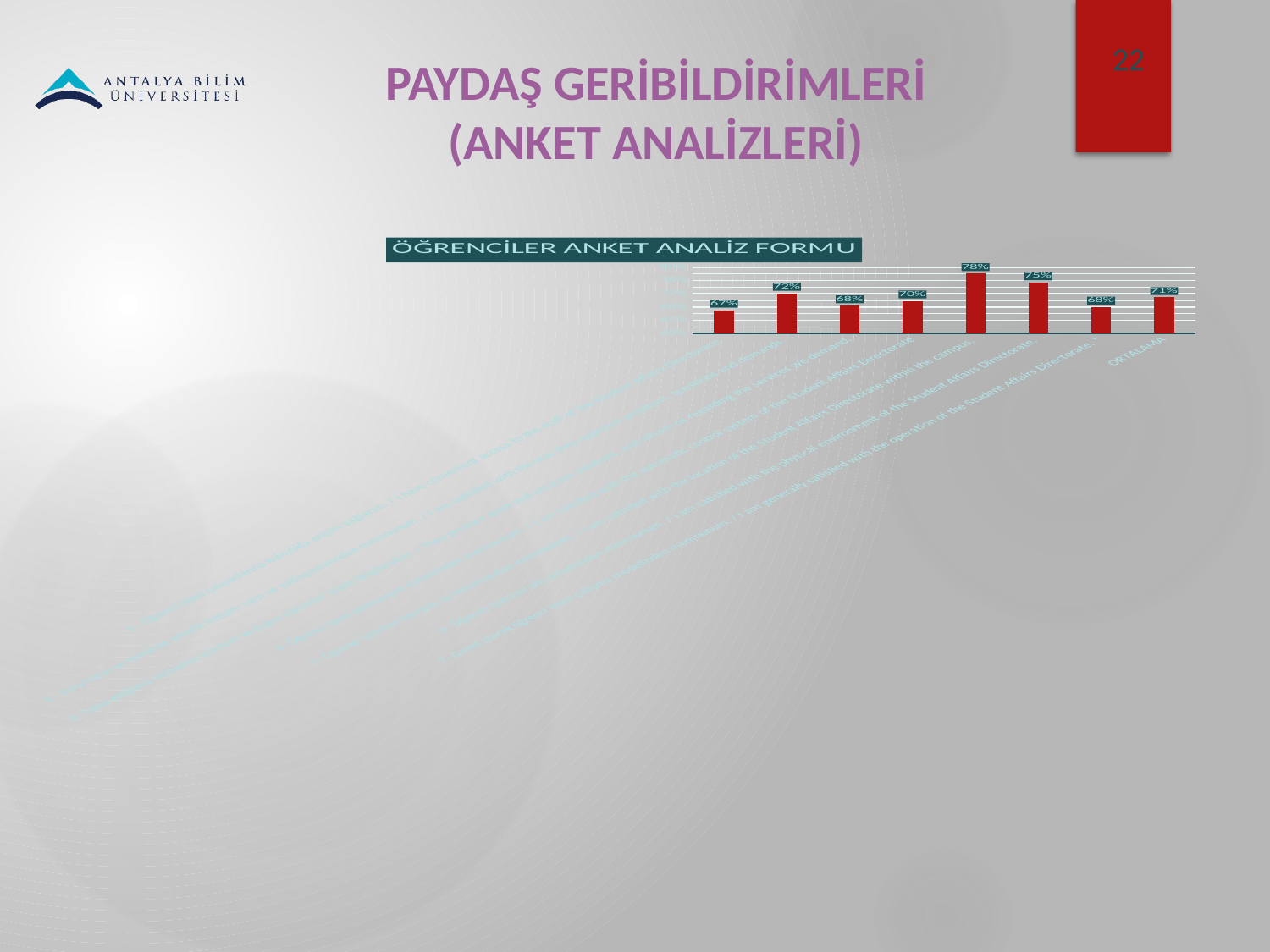
What is the difference between the fifth bar (78%) and the sixth bar (75%)? 3% Which is larger: the second bar from the left or the third bar from the left? the second bar (72%) How many bars are plotted in the chart? 8 What kind of chart is shown on the slide? bar chart What is the lowest value shown in the chart? 67% What is the title of the chart? ÖĞRENCİLER ANKET ANALİZ FORMU What is the difference between the highest and lowest values in the chart? 11% What is the value of the first (leftmost) bar in the chart? 67% What is the value of the sixth bar from the left? 75% What is the highest value shown in the chart? 78% What is the value of the last bar, labelled ORTALAMA? 71% What is the value of the fifth bar from the left? 78%